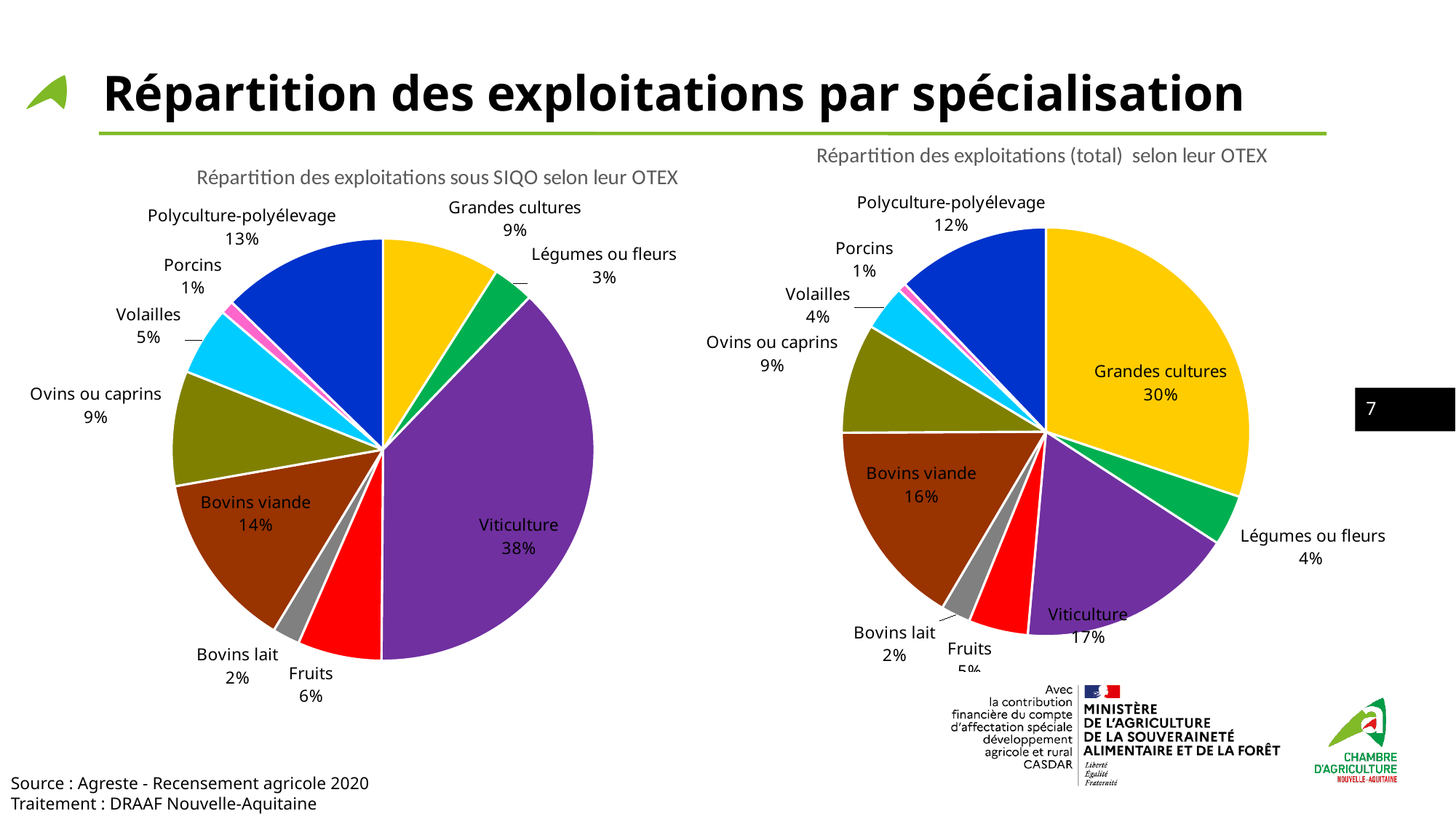
In the chart 'Répartition des exploitations sous SIQO selon leur OTEX', which category has the largest slice? Viticulture In the chart 'Répartition des exploitations (total) selon leur OTEX', what share does Viticulture have? 17% In the chart 'Répartition des exploitations sous SIQO selon leur OTEX', what share does Viticulture have? 38% In the chart 'Répartition des exploitations sous SIQO selon leur OTEX', what is the difference between the shares of Viticulture and Polyculture-polyélevage? 25 percentage points What type of chart is used on the left side of the slide? Pie chart In the chart 'Répartition des exploitations sous SIQO selon leur OTEX', which category has the smallest slice? Porcins How many categories are shown in the chart 'Répartition des exploitations sous SIQO selon leur OTEX'? 10 In the chart 'Répartition des exploitations (total) selon leur OTEX', what is the difference between the shares of Grandes cultures and Bovins viande? 14 percentage points In the chart 'Répartition des exploitations (total) selon leur OTEX', what share does Grandes cultures have? 30% In the chart 'Répartition des exploitations (total) selon leur OTEX', which is larger, Bovins viande or Polyculture-polyélevage? Bovins viande In the chart 'Répartition des exploitations (total) selon leur OTEX', which category has the largest slice? Grandes cultures In the chart 'Répartition des exploitations sous SIQO selon leur OTEX', what share does Bovins viande have? 14%